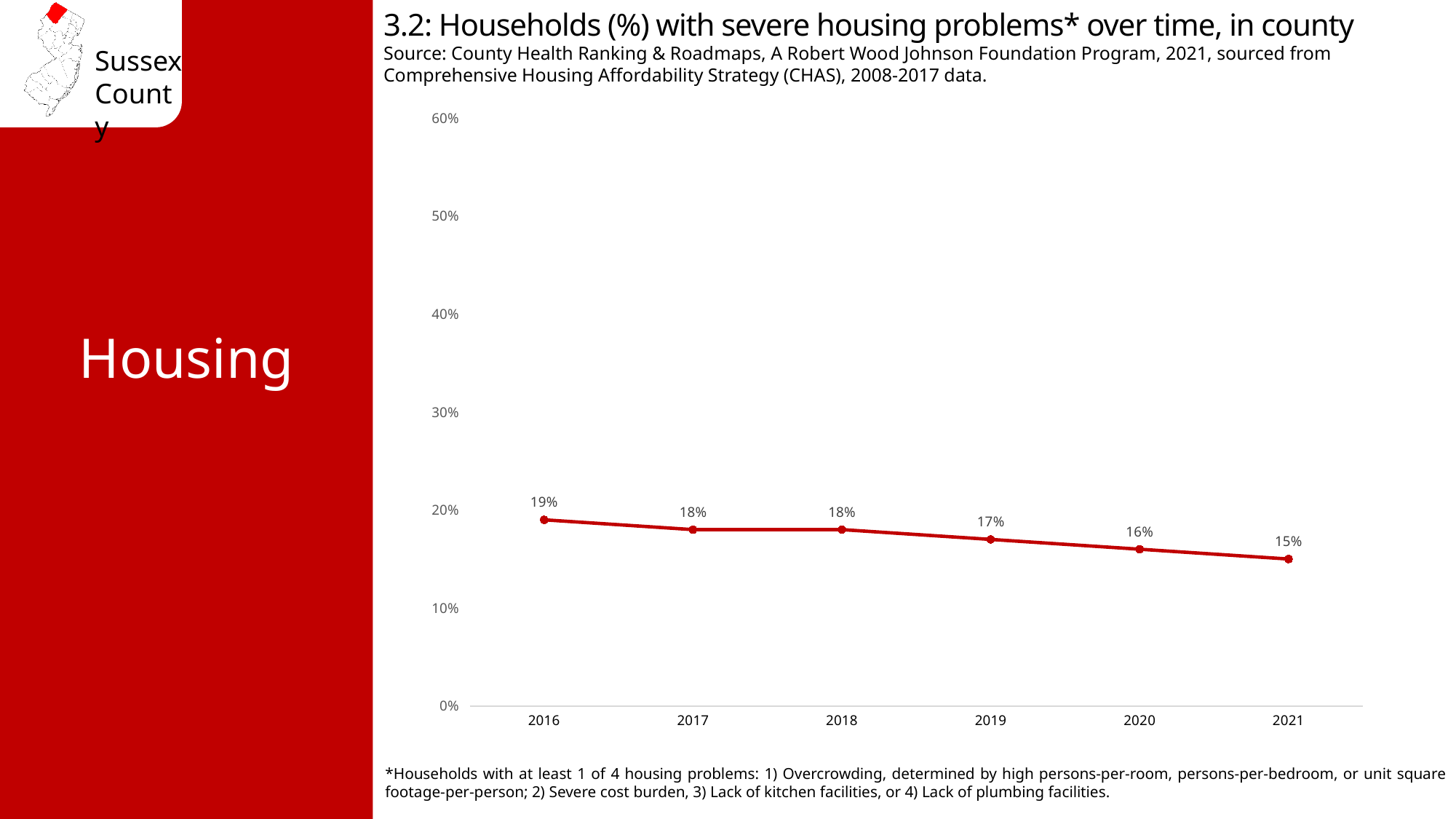
What is the highest value labelled on the vertical axis? 60% Do the values rise or fall from 2016 to 2021? fall What is the value shown for 2019? 17% Which year has the lowest percentage of households with severe housing problems? 2021 Which year has the highest percentage of households with severe housing problems? 2016 What kind of chart is shown on the slide? line chart What is the difference between the 2016 value and the 2021 value? 4% Which year has a higher value, 2017 or 2020? 2017 What percentage of households had severe housing problems in 2016? 19% How many years are plotted on the chart? 6 Is the value for 2018 greater or less than 20%? less What percentage of households had severe housing problems in 2021? 15%